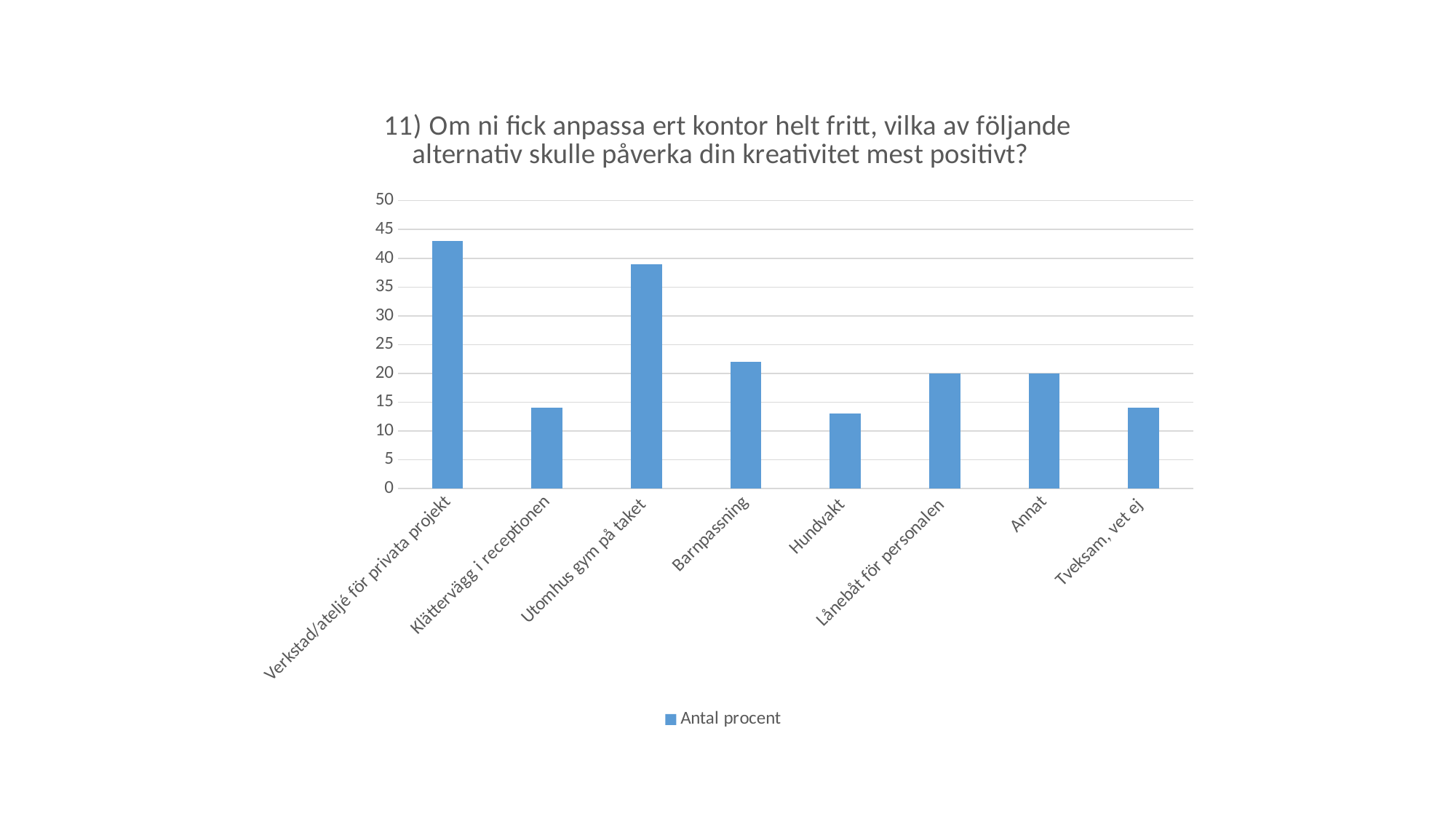
Is the value for Hundvakt greater or less than 15? less Is the value for Verkstad/ateljé för privata projekt greater or less than 40? greater Which is larger, the value for Barnpassning or the value for Tveksam, vet ej? Barnpassning Which is larger, the value for Verkstad/ateljé för privata projekt or the value for Utomhus gym på taket? Verkstad/ateljé för privata projekt Which category has the highest value? Verkstad/ateljé för privata projekt What is the name of the series in the legend? Antal procent How many series does the legend list? 1 What kind of chart is shown on the slide? bar chart How many categories are shown on the x axis? 8 Is the value for Barnpassning greater or less than 20? greater